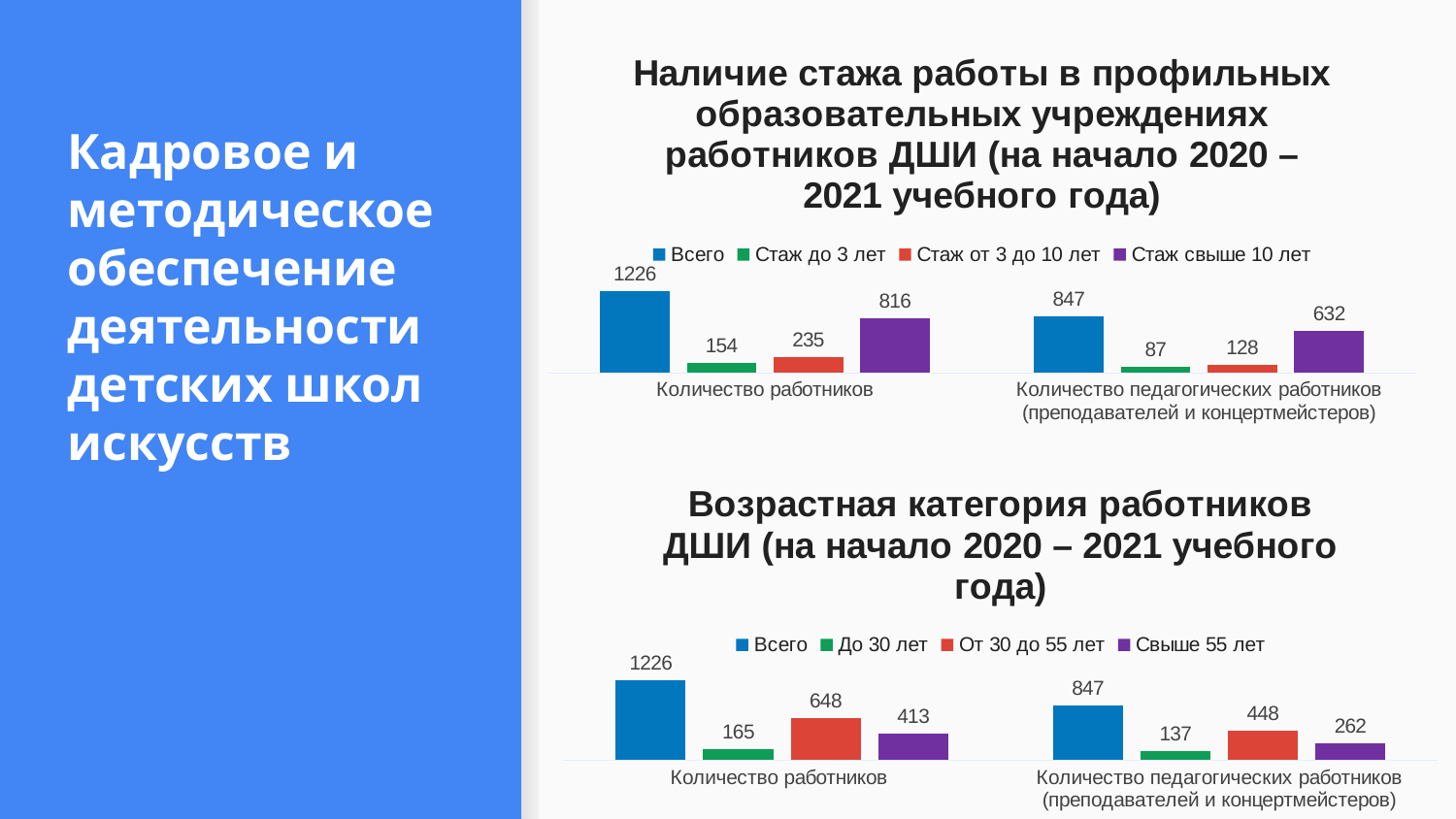
In the top chart (Наличие стажа работы), what is the difference between 'Всего' and 'Стаж свыше 10 лет' for 'Количество работников'? 410 In the top chart (Наличие стажа работы), which series has the lowest value in the 'Количество педагогических работников' category? Стаж до 3 лет In the bottom chart (Возрастная категория работников), what is the value for 'От 30 до 55 лет' in the 'Количество работников' category? 648 In the top chart (Наличие стажа работы), what is the value for 'Стаж свыше 10 лет' in the 'Количество работников' category? 816 In the bottom chart (Возрастная категория работников), which is larger for 'Количество работников': 'До 30 лет' or 'Свыше 55 лет'? Свыше 55 лет In the top chart (Наличие стажа работы), how many series does the legend list? 4 In the bottom chart (Возрастная категория работников), what is the value for 'Свыше 55 лет' among педагогических работников? 262 In the bottom chart (Возрастная категория работников), how many categories are shown on the x axis? 2 In the top chart (Наличие стажа работы), what is the value for 'Стаж до 3 лет' among педагогических работников? 87 In the top chart (Наличие стажа работы), what colour represents the 'Всего' series? Blue What type of chart is the bottom chart (Возрастная категория работников)? Bar chart In the bottom chart (Возрастная категория работников), what is the difference between 'От 30 до 55 лет' and 'Свыше 55 лет' for педагогических работников? 186